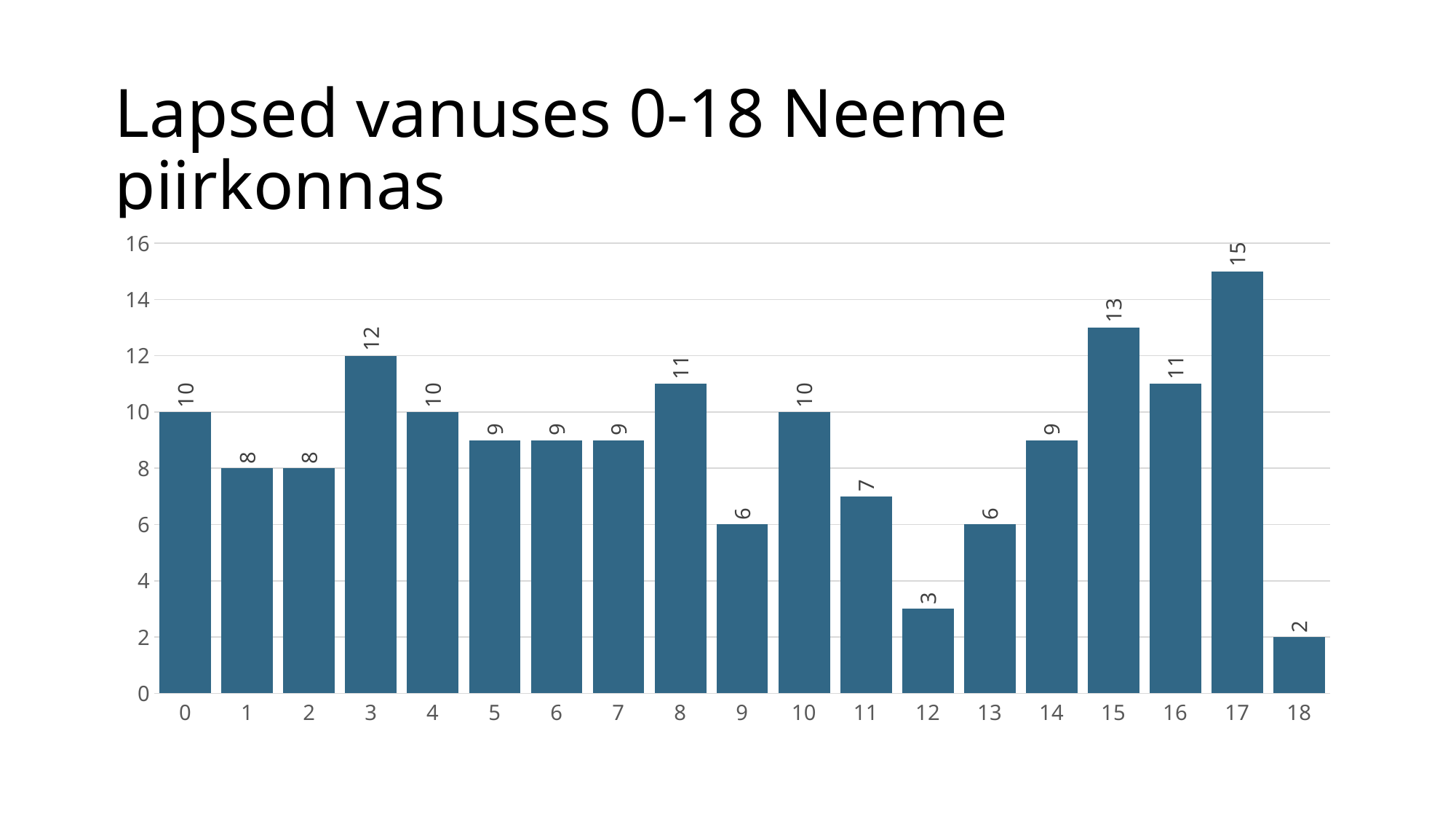
Is the value for age 16 greater or less than 10? greater What is the difference between the values for age 3 and age 9? 6 Which age has the lowest value? 18 How many age categories are shown on the x axis? 19 What is the value for age 15? 13 What is the value for age 12? 3 Which age has the highest value? 17 What is the title of the chart? Lapsed vanuses 0-18 Neeme piirkonnas What is the value for age 3? 12 What is the difference between the values for age 17 and age 18? 13 What kind of chart is shown on the slide? bar chart Which is larger, the value for age 8 or the value for age 11? age 8